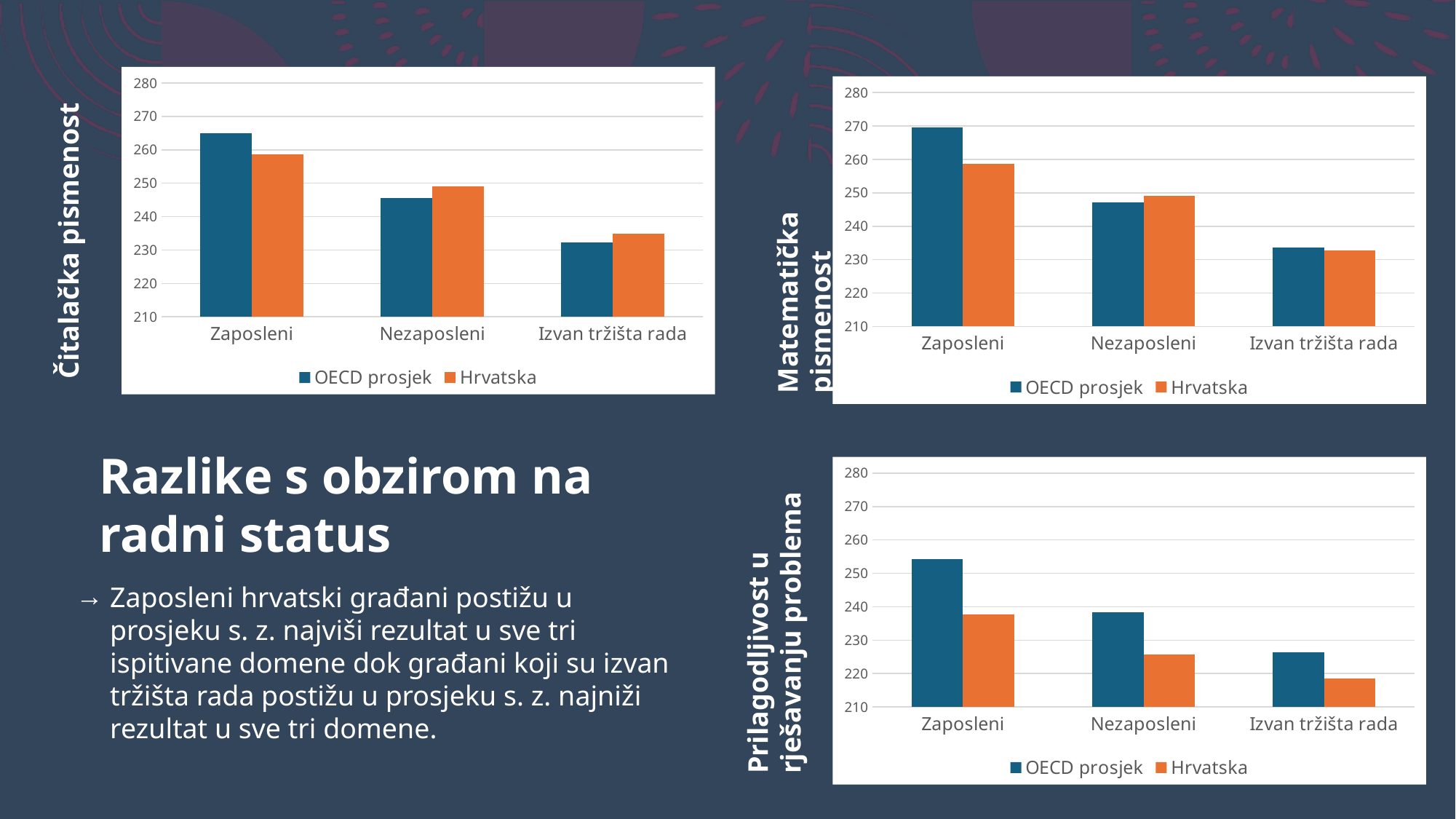
Which colour represents the Hrvatska series in the charts? orange What kind of chart is the 'Čitalačka pismenost' chart? bar chart In the 'Čitalačka pismenost' chart, which is larger for Nezaposleni: OECD prosjek or Hrvatska? Hrvatska In the 'Matematička pismenost' chart, which is larger for Zaposleni: OECD prosjek or Hrvatska? OECD prosjek In the 'Čitalačka pismenost' chart, is the OECD prosjek value for Zaposleni greater or less than 260? greater How many categories are shown on the x axis of the 'Prilagodljivost u rješavanju problema' chart? 3 How many series does the legend of the 'Matematička pismenost' chart list? 2 In the 'Matematička pismenost' chart, is the Hrvatska value for Izvan tržišta rada greater or less than 240? less In the 'Matematička pismenost' chart, which category has the highest OECD prosjek value? Zaposleni In the 'Prilagodljivost u rješavanju problema' chart, which category has the lowest Hrvatska value? Izvan tržišta rada In the 'Prilagodljivost u rješavanju problema' chart, is the OECD prosjek value for Zaposleni greater or less than 250? greater In the 'Prilagodljivost u rješavanju problema' chart, do the Hrvatska values rise or fall from Zaposleni to Izvan tržišta rada? fall